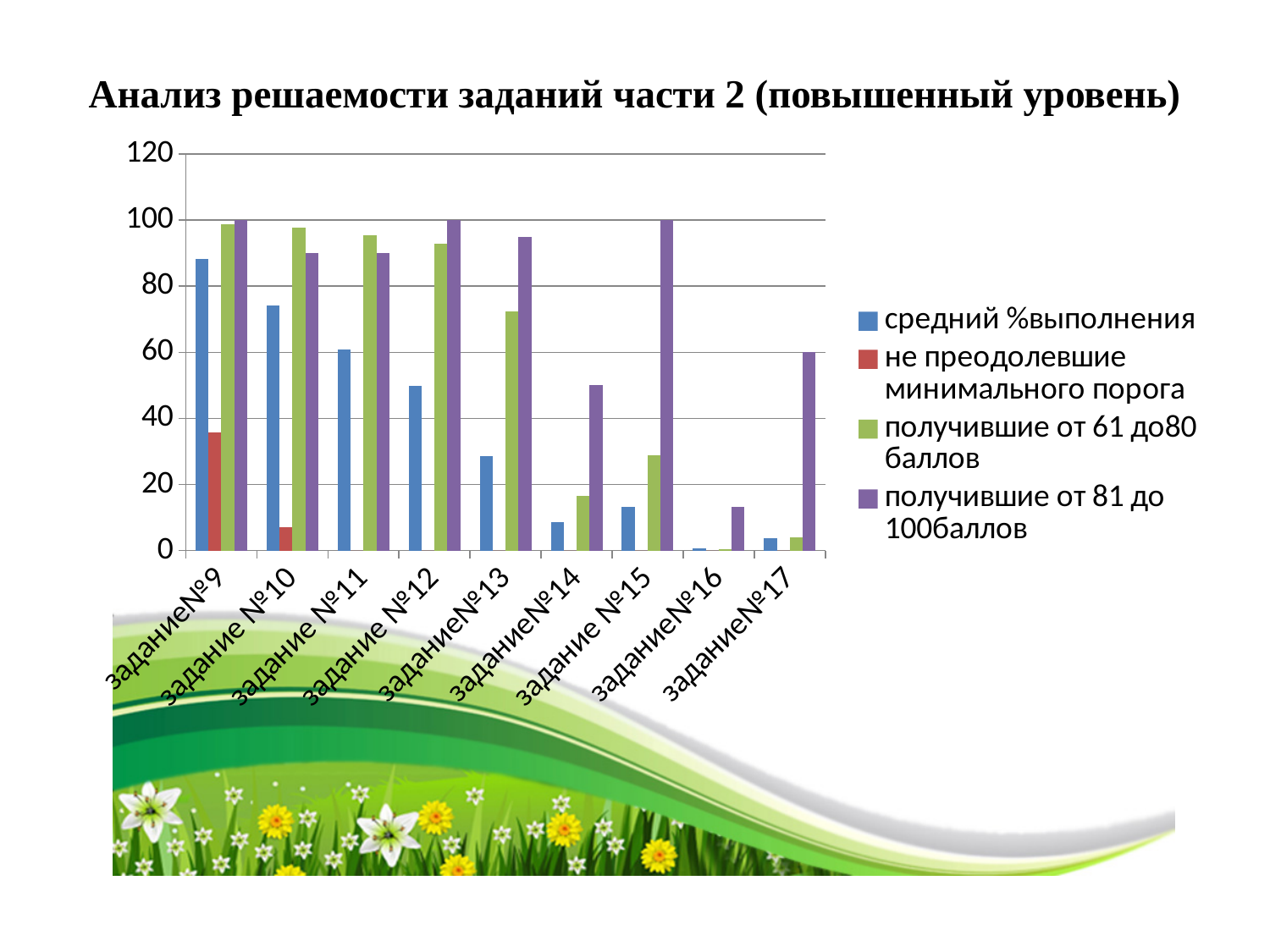
Which task has the lowest value for 'средний %выполнения'? задание№16 For задание№13, which is larger: 'получившие от 61 до80 баллов' or 'получившие от 81 до 100баллов'? получившие от 81 до 100баллов What is the value of the 'получившие от 81 до 100баллов' series for задание№17? 60 Which colour represents the 'средний %выполнения' series in the legend? blue What is the value of the 'получившие от 81 до 100баллов' series for задание№9? 100 Which task has the highest value for 'средний %выполнения'? задание№9 How many series does the legend list? 4 Is the value of 'средний %выполнения' for задание№9 greater or less than 80? greater What kind of chart is shown on the slide? bar chart How many task categories are shown along the x axis? 9 Is the value of 'получившие от 61 до80 баллов' for задание№13 greater or less than 60? greater Is the value of 'средний %выполнения' for задание №10 greater or less than 80? less